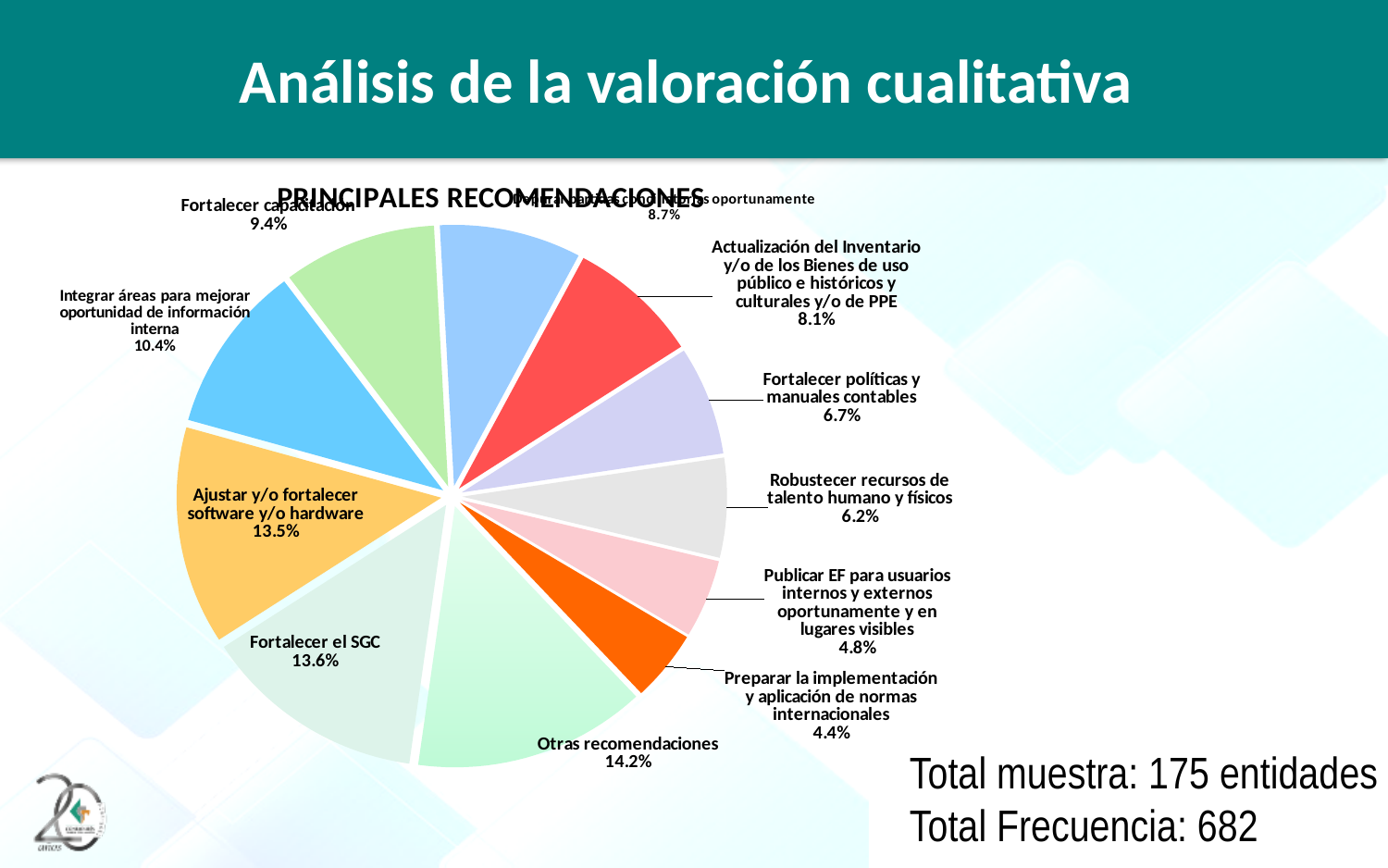
Which is larger: the share for "Robustecer recursos de talento humano y físicos" or the share for "Publicar EF para usuarios internos y externos oportunamente y en lugares visibles"? Robustecer recursos de talento humano y físicos What percentage is shown for "Fortalecer el SGC"? 13.6% What percentage is shown for "Fortalecer políticas y manuales contables"? 6.7% What share of the pie does "Otras recomendaciones" represent? 14.2% How many slices does the pie chart have? 11 Which category has the smallest share of the pie? Preparar la implementación y aplicación de normas internacionales What percentage is shown for "Ajustar y/o fortalecer software y/o hardware"? 13.5% What percentage is shown for "Preparar la implementación y aplicación de normas internacionales"? 4.4% What is the difference in percentage points between "Integrar áreas para mejorar oportunidad de información interna" and "Fortalecer capacitación"? 1.0 Which category has the largest share of the pie? Otras recomendaciones What kind of chart is shown on the slide? Pie chart What is the title of the pie chart? PRINCIPALES RECOMENDACIONES